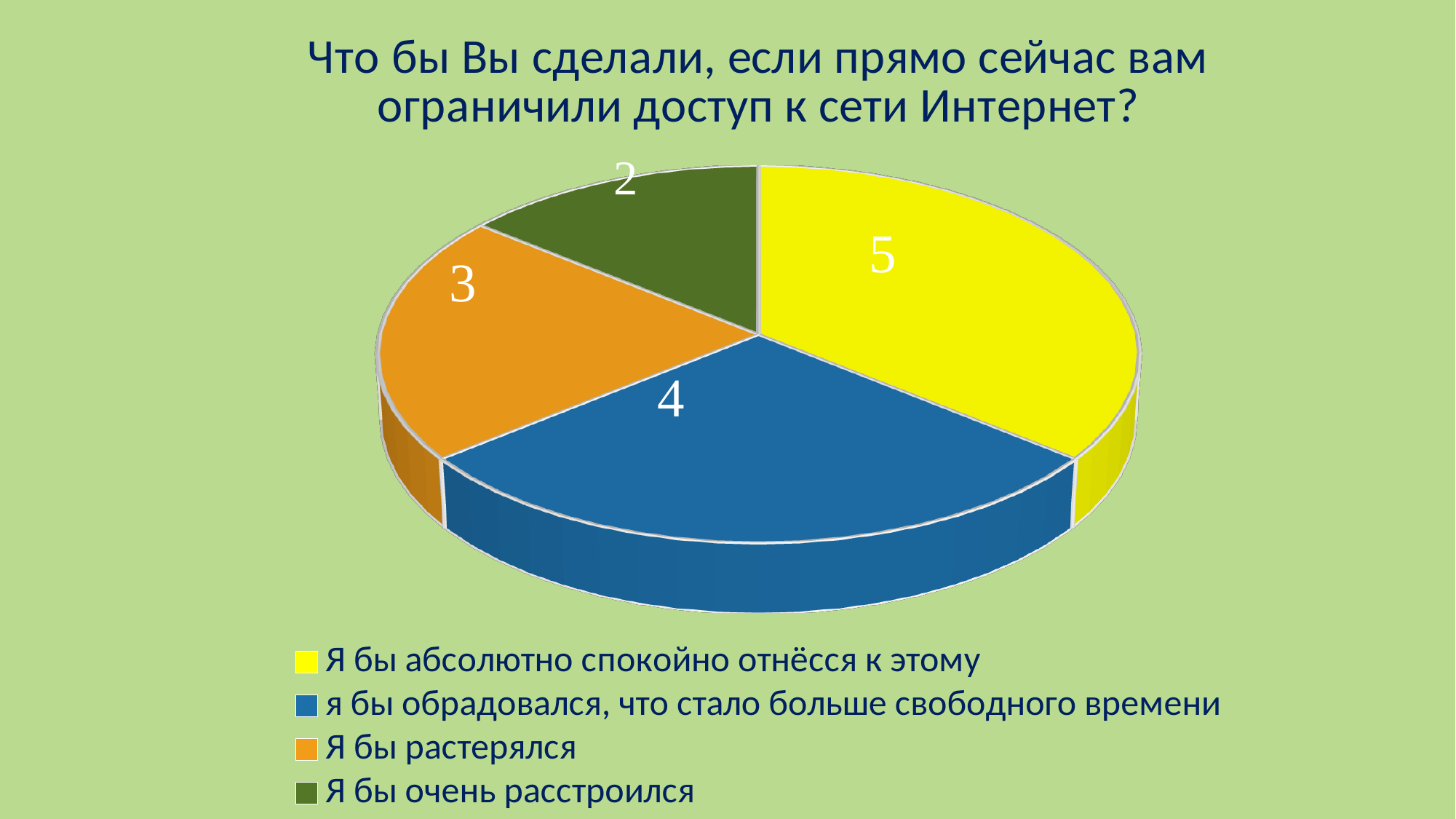
What is the value for "Я бы растерялся"? 3 What is the difference between the values for "Я бы абсолютно спокойно отнёсся к этому" and "Я бы очень расстроился"? 3 Which answer option has the largest slice? Я бы абсолютно спокойно отнёсся к этому Which answer option has the smallest slice? Я бы очень расстроился What is the value for "я бы обрадовался, что стало больше свободного времени"? 4 How many slices does the pie chart have? 4 Which is larger: the value for "Я бы растерялся" or the value for "я бы обрадовался, что стало больше свободного времени"? я бы обрадовался, что стало больше свободного времени What colour is the slice for "Я бы растерялся"? orange What is the value for "Я бы абсолютно спокойно отнёсся к этому"? 5 What is the total of all the slice values in the pie chart? 14 What kind of chart is shown on the slide? pie chart What is the value for "Я бы очень расстроился"? 2